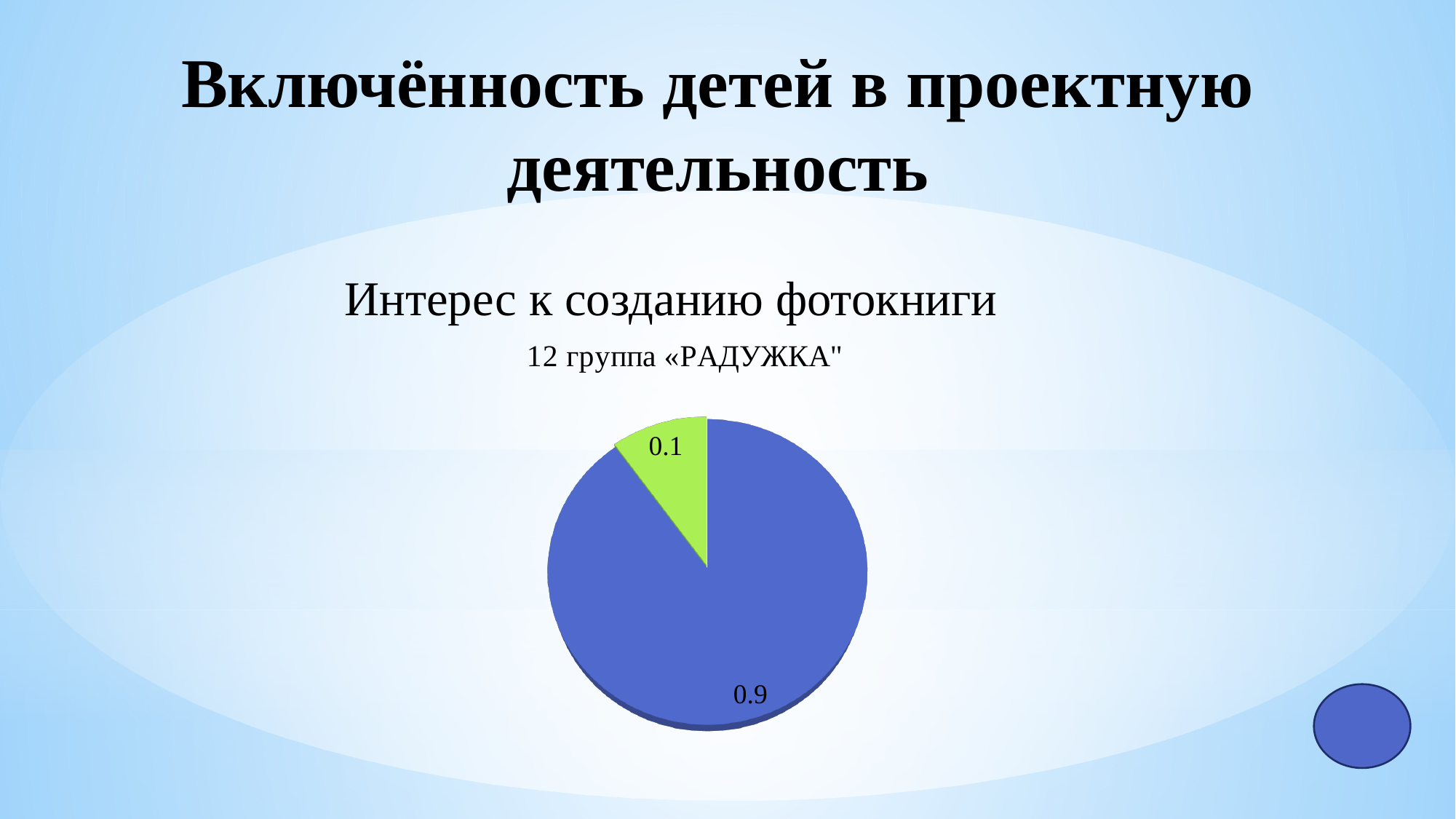
Which slice of the pie chart is the smallest? the green slice (0.1) What share of the pie does the green slice represent? 0.1 What is the difference between the values of the blue slice and the green slice? 0.8 What value is labelled on the green slice of the pie chart? 0.1 What value is labelled on the blue slice of the pie chart? 0.9 Which slice of the pie chart is the largest? the blue slice (0.9) What is the title of the chart? 12 группа «РАДУЖКА" What kind of chart is shown on the slide? pie chart What colour is the largest slice of the pie chart? blue Which is larger, the blue slice or the green slice? the blue slice How many slices does the pie chart have? 2 What is the total of the two values labelled on the pie chart? 1.0